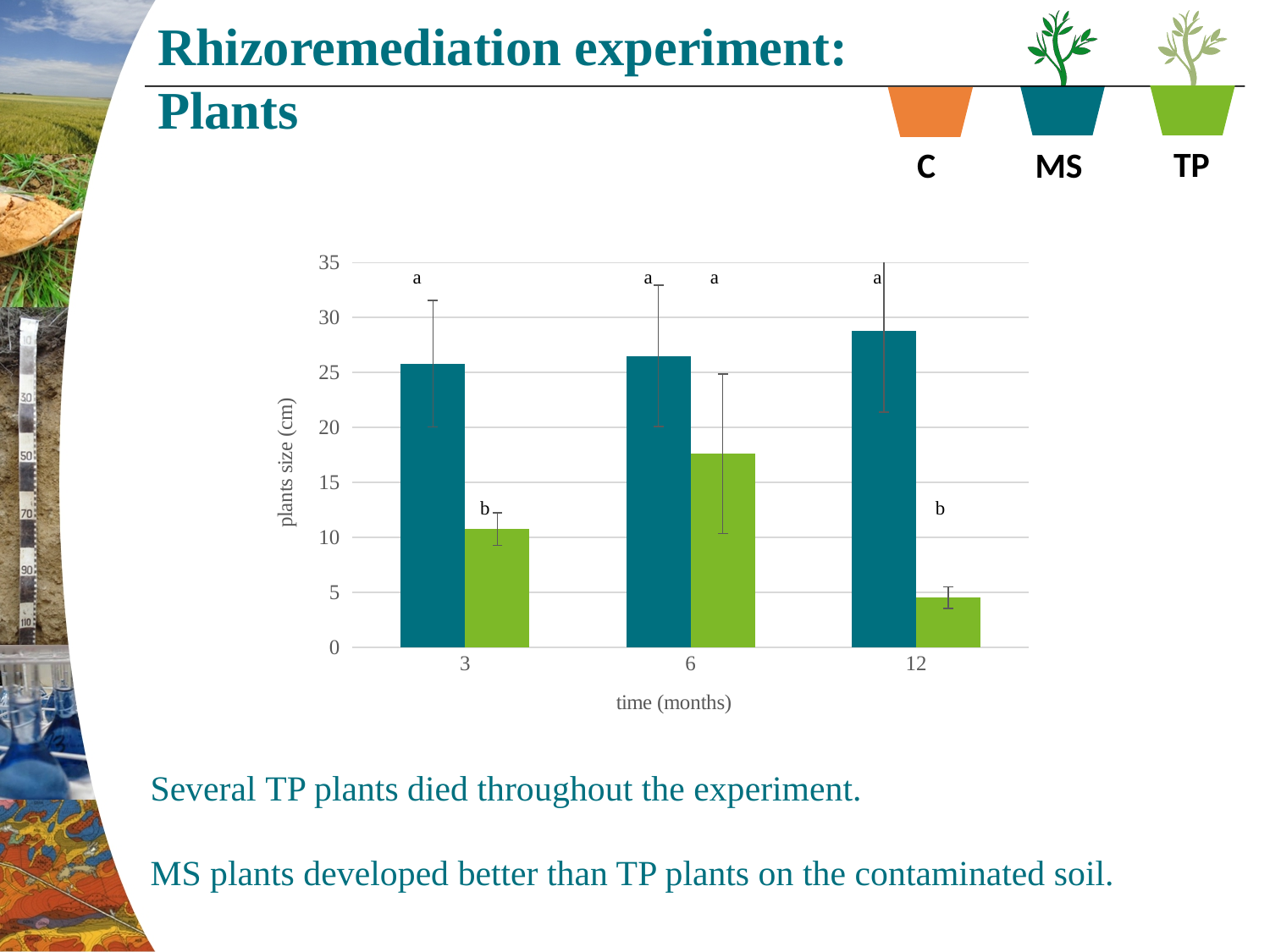
Is the value for TP plants at 12 months greater or less than 5? less At which time point is the TP plant size highest? 6 At 6 months, which is larger: the plant size for MS or for TP? MS At which time point is the TP plant size lowest? 12 Is the value for TP plants at 6 months greater or less than 15? greater Is the value for MS plants at 3 months greater or less than 20? greater What is the label of the x axis of the chart? time (months) How many time points (categories) are shown on the x axis of the chart? 3 What kind of chart is shown on the slide? bar chart What is the label of the y axis of the chart? plants size (cm)